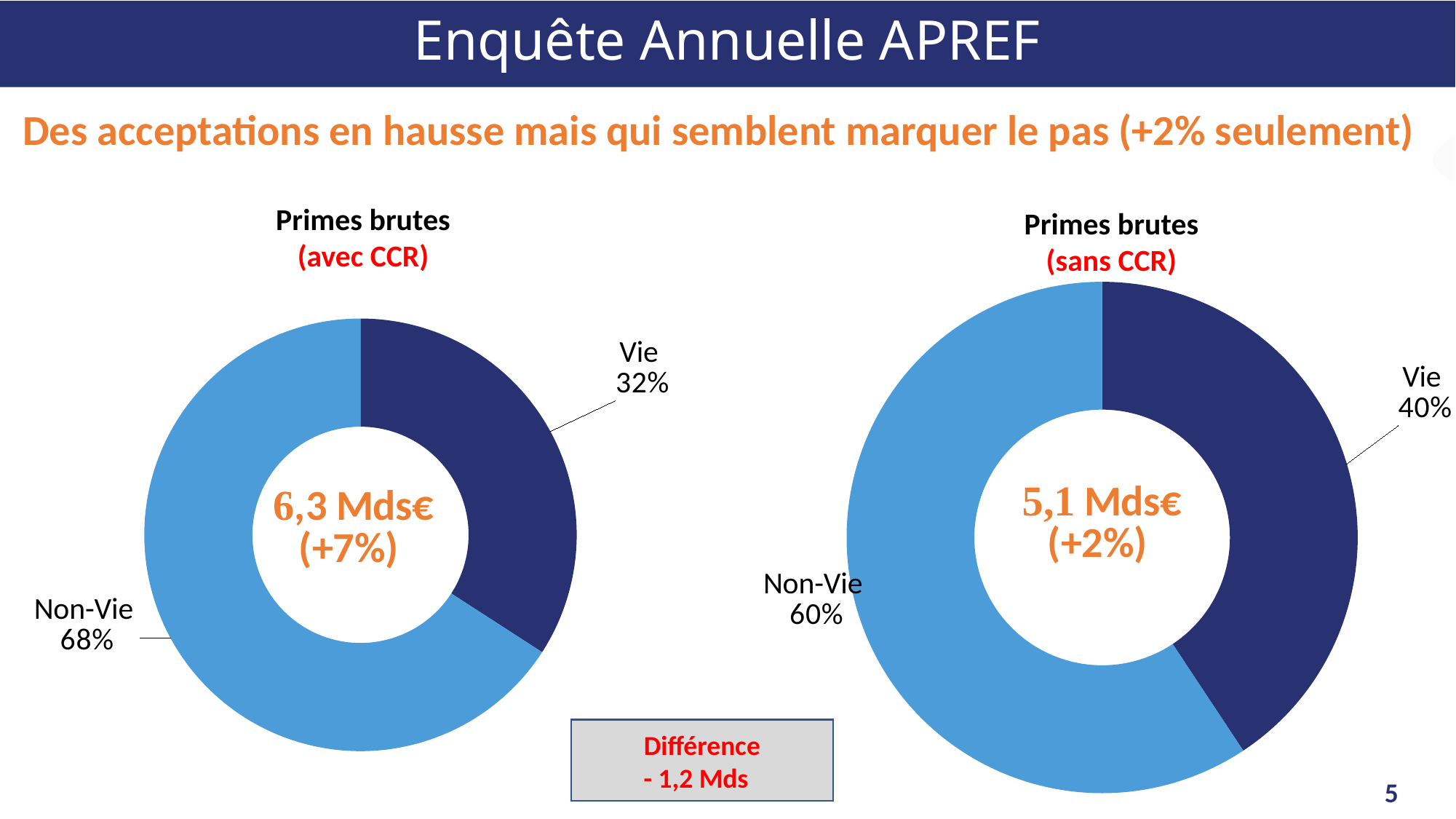
What kind of chart is the 'Primes brutes (sans CCR)' chart? Doughnut chart Is the Vie share larger in the 'Primes brutes (avec CCR)' chart or in the 'Primes brutes (sans CCR)' chart? Primes brutes (sans CCR) In the 'Primes brutes (sans CCR)' chart, what is the difference between the Non-Vie and Vie shares? 20% In the 'Primes brutes (sans CCR)' chart, what share does Non-Vie have? 60% In the 'Primes brutes (sans CCR)' chart, what share does Vie have? 40% In the 'Primes brutes (avec CCR)' chart, what share does Non-Vie have? 68% In the 'Primes brutes (avec CCR)' chart, what is the difference between the Non-Vie and Vie shares? 36% In the 'Primes brutes (sans CCR)' chart, which category has the smallest share? Vie What total value is printed in the centre of the 'Primes brutes (avec CCR)' chart? 6,3 Mds€ (+7%) How many categories does the 'Primes brutes (avec CCR)' chart show? 2 In the 'Primes brutes (avec CCR)' chart, what share does Vie have? 32% In the 'Primes brutes (avec CCR)' chart, which category has the largest share? Non-Vie